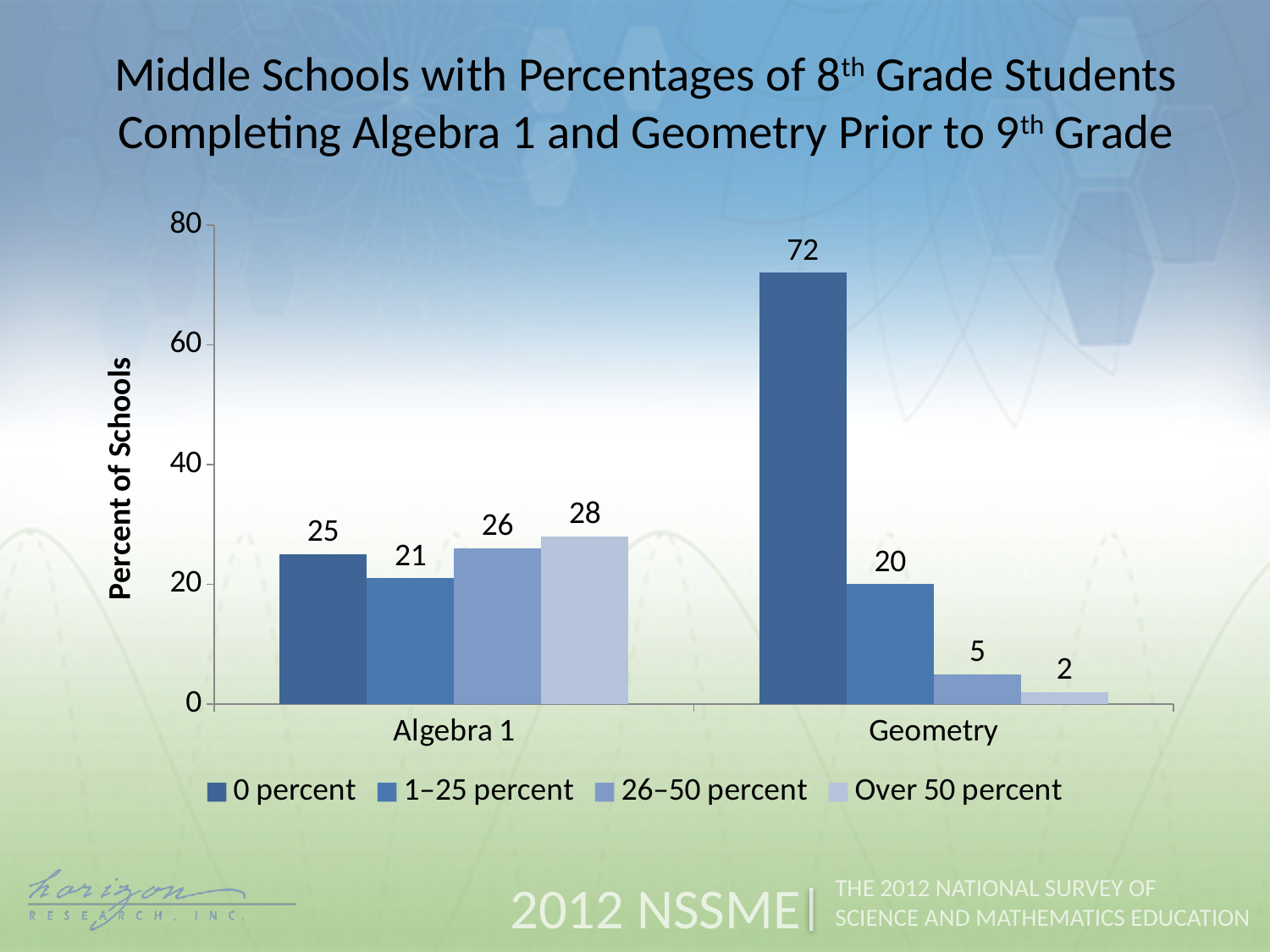
Is the value for the 0 percent series for Geometry greater or less than 60? greater What is the value for the Over 50 percent series for Algebra 1? 28 How many series does the legend list? 4 What is the difference between the 0 percent values for Geometry and Algebra 1? 47 How many categories are shown on the x axis? 2 What is the value for the 1–25 percent series for Algebra 1? 21 Which series has the highest value for Geometry? 0 percent What is the value for the 0 percent series for Geometry? 72 Which series has the lowest value for Algebra 1? 1–25 percent What kind of chart is shown on the slide? Bar chart What is the value for the 26–50 percent series for Geometry? 5 Which is larger: the Over 50 percent value for Algebra 1 or for Geometry? Algebra 1